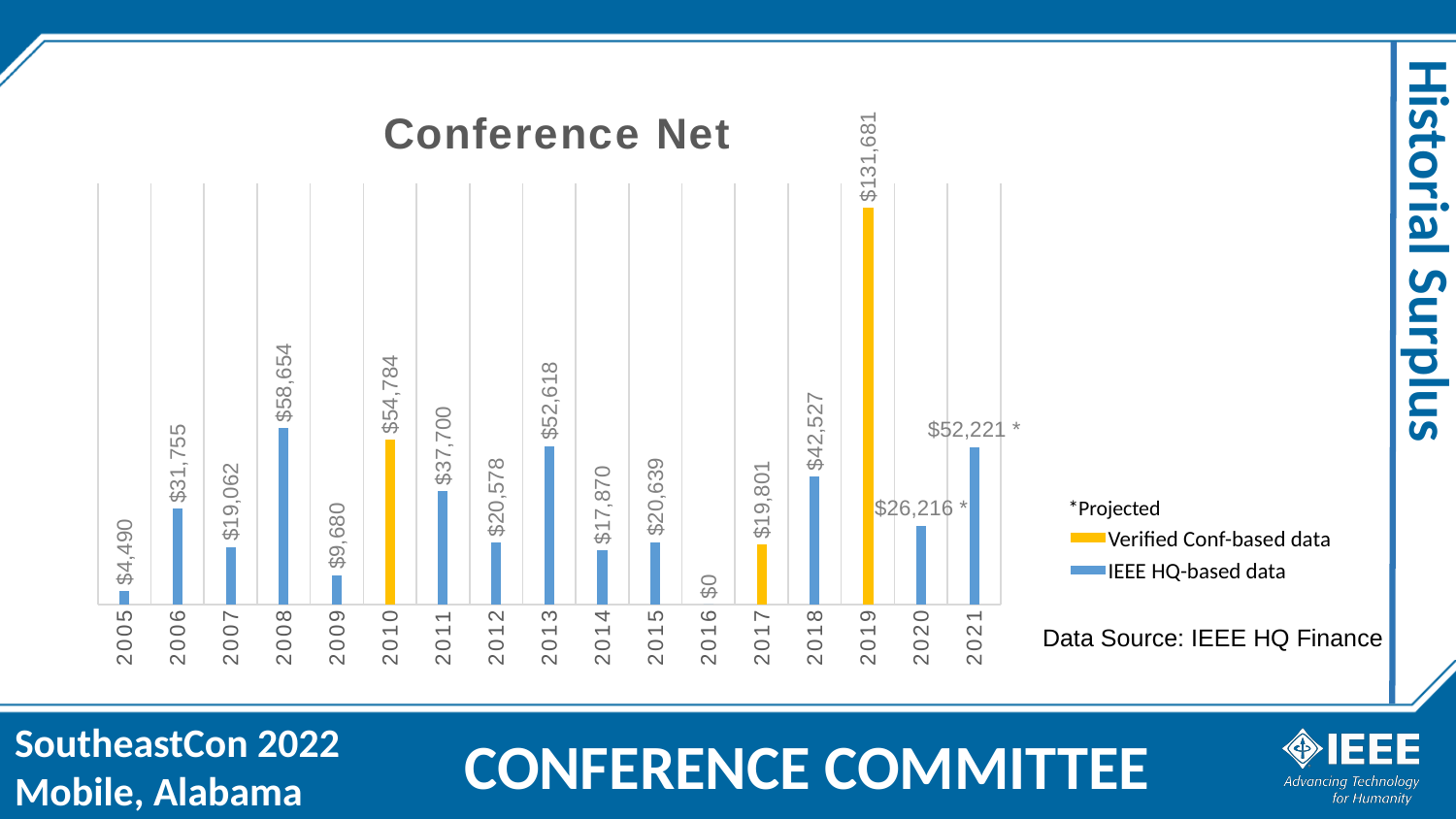
What kind of chart is the Conference Net chart? Bar chart What is the Conference Net value for 2008? $58,654 Which year has a larger Conference Net, 2008 or 2010? 2008 What is the projected Conference Net value for 2021? $52,221 How many years are shown on the x axis of the Conference Net chart? 17 How many series does the legend of the Conference Net chart list? 2 Which year has the lowest Conference Net? 2016 What is the difference between the Conference Net for 2019 and 2018? $89,154 What is the Conference Net value for 2016? $0 What is the Conference Net value for 2019? $131,681 Which years are shown as Verified Conf-based data (yellow bars)? 2010, 2017, 2019 Which year has the highest Conference Net? 2019